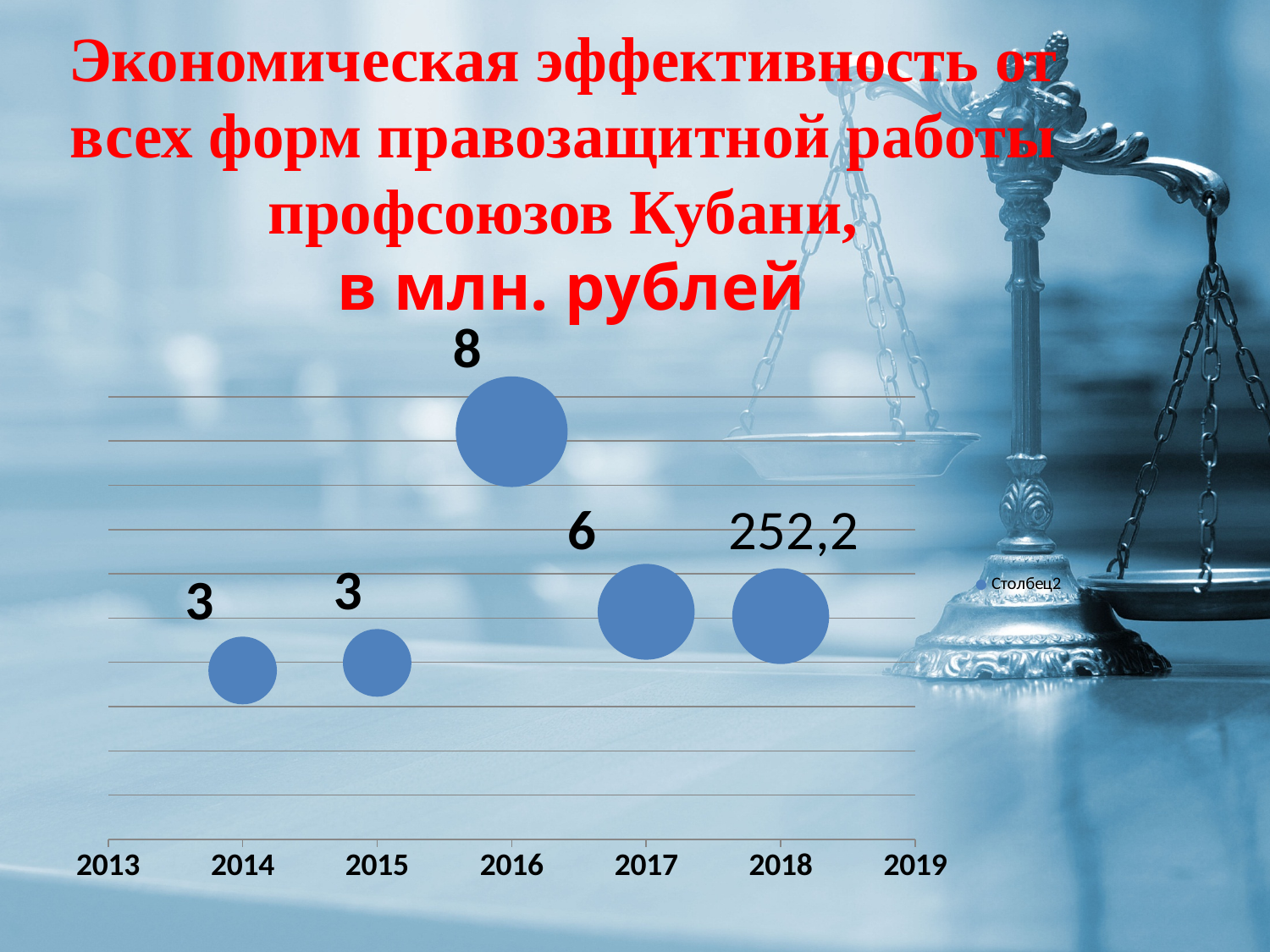
How many data points (bubbles) are plotted on the chart? 5 What value is labelled for 2016? 8 What is the difference between the labelled values for 2016 and 2017? 2 What value is labelled for 2015? 3 What value is labelled for 2014? 3 Which has the larger labelled value, 2016 or 2017? 2016 What is the name of the series shown in the legend? Столбец2 Which has the larger labelled value, 2015 or 2016? 2016 What value is labelled for 2017? 6 What value is labelled for 2018? 252,2 What kind of chart is shown on the slide? Bubble chart How many series does the legend list? 1